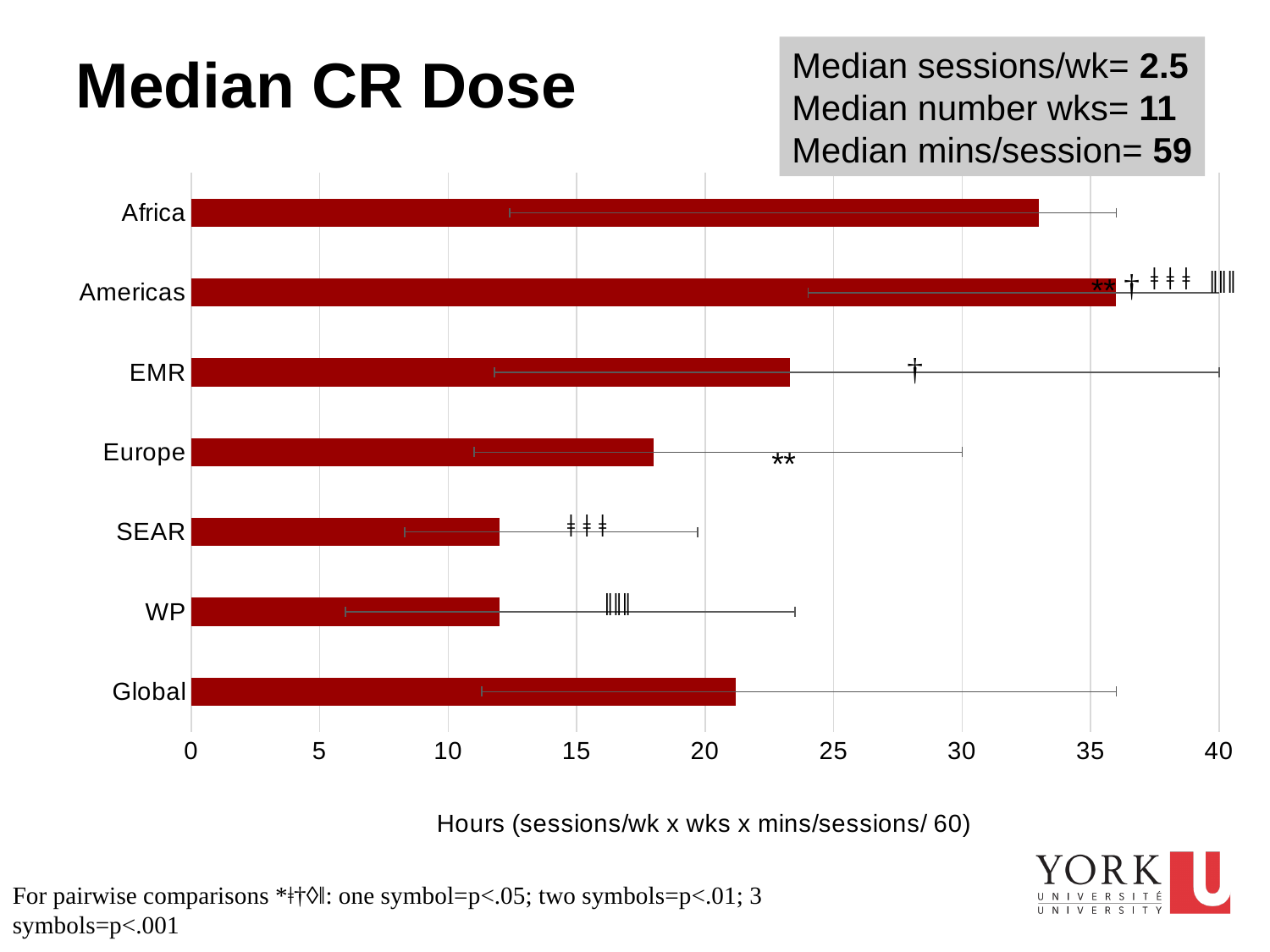
How many categories are plotted on the chart? 7 Is the value for Africa greater or less than 30? greater Is the value for SEAR greater or less than 15? less Which category has the highest value on the chart? Americas Is the value for Europe greater or less than 20? less What kind of chart is shown on the slide? bar chart What is the title of the chart? Median CR Dose Which has a larger value, Africa or Europe? Africa What is the label on the horizontal axis of the chart? Hours (sessions/wk x wks x mins/sessions/ 60) Which has a larger value, EMR or Global? EMR